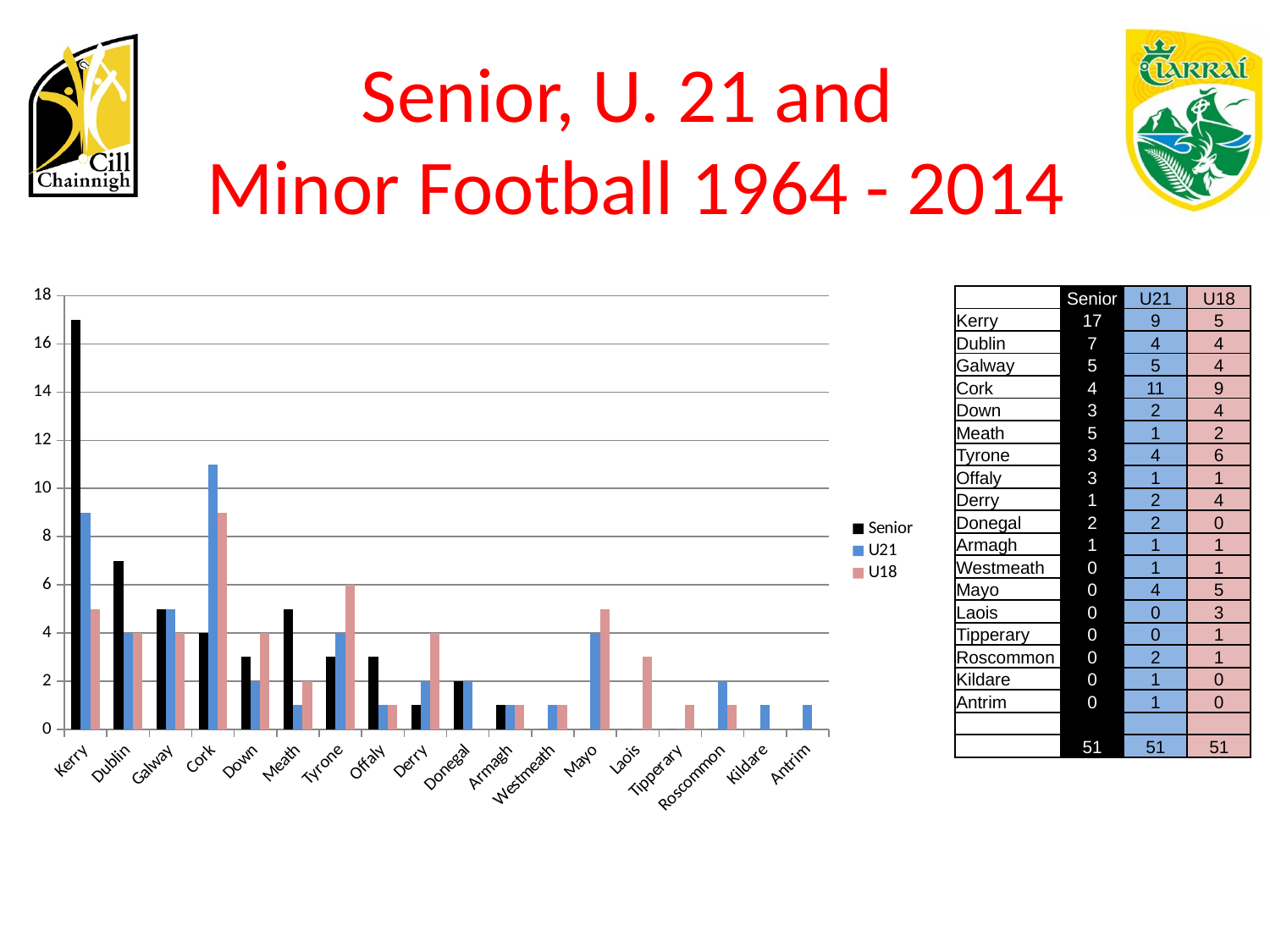
What kind of chart is shown on the slide? bar chart Which is larger, the U18 value for Cork or the U18 value for Kerry? Cork Which county has the highest U21 value? Cork What is the U21 value for Cork? 11 How many counties are shown on the x axis of the chart? 18 Is the Senior value for Kerry greater or less than 16? greater How many series does the chart legend list? 3 What colour are the Senior bars in the chart? black What is the U18 value for Tyrone? 6 What is the difference between Kerry's Senior value and Dublin's Senior value? 10 Which county has the highest Senior value? Kerry What is the Senior value for Kerry? 17